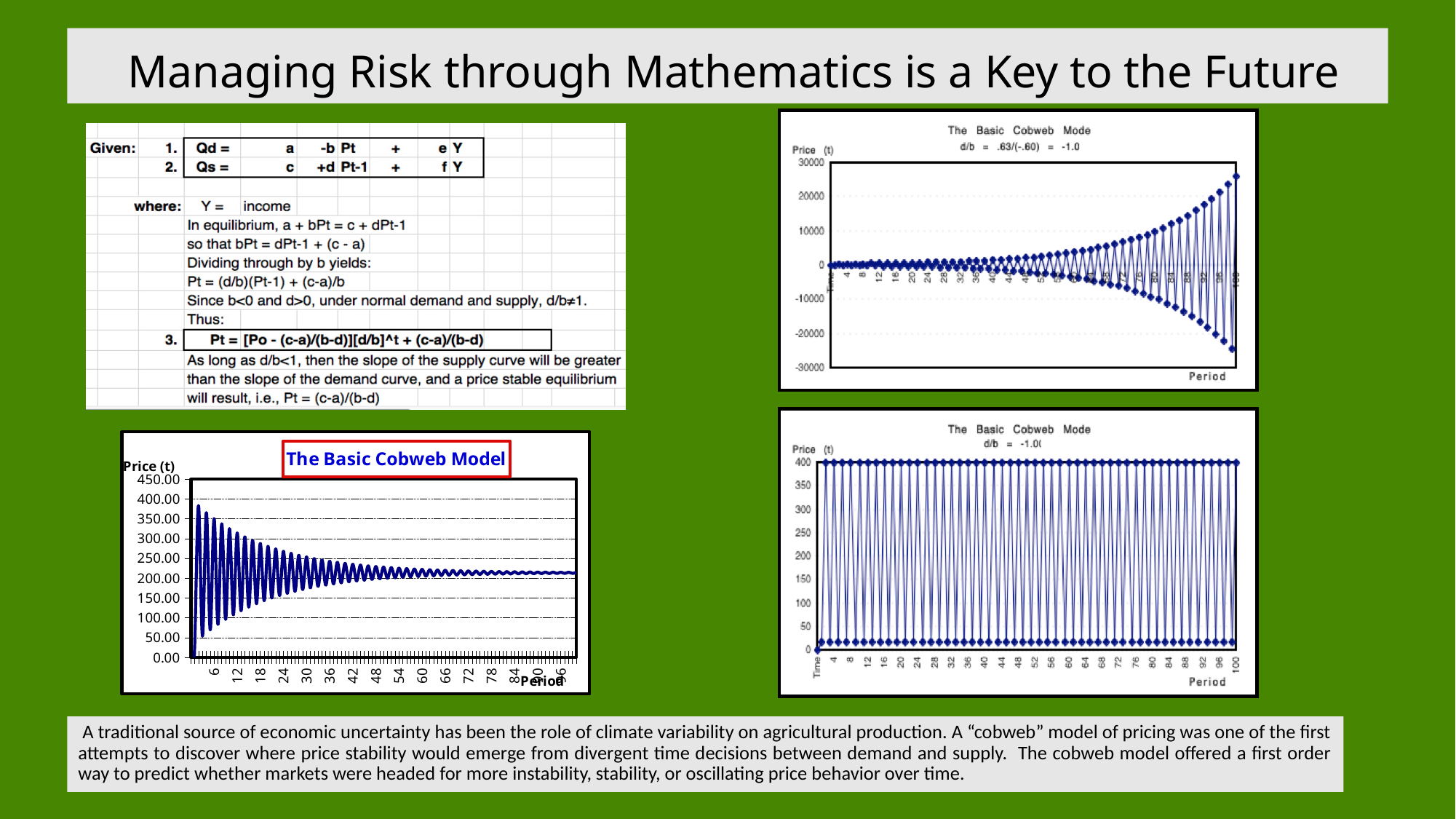
In the bottom-left chart "The Basic Cobweb Model", is the level the price settles toward at the end greater or less than 250.00? less In the bottom-left chart "The Basic Cobweb Model", what is the highest tick value shown on the vertical axis? 450.00 In the top-right chart "The Basic Cobweb Mode", what is the lowest tick value shown on the vertical axis? -30000 In the bottom-left chart "The Basic Cobweb Model", what is the label on the vertical axis? Price (t) In the bottom-left chart "The Basic Cobweb Model", is the first peak of the price series greater or less than 350.00? greater What kind of chart is the bottom-left chart titled "The Basic Cobweb Model"? line chart In the top-right chart "The Basic Cobweb Mode", is the final peak of the price series greater or less than 20000? greater In the bottom-right chart "The Basic Cobweb Mode", what value do the upper peaks of the price series reach? 400 In the bottom-left chart "The Basic Cobweb Model", does the size of the price swings grow or shrink as the period increases? shrink In the top-right chart "The Basic Cobweb Mode" with d/b = -1.0, does the size of the price swings grow or shrink as the period increases? grow How many charts are shown on the slide? 3